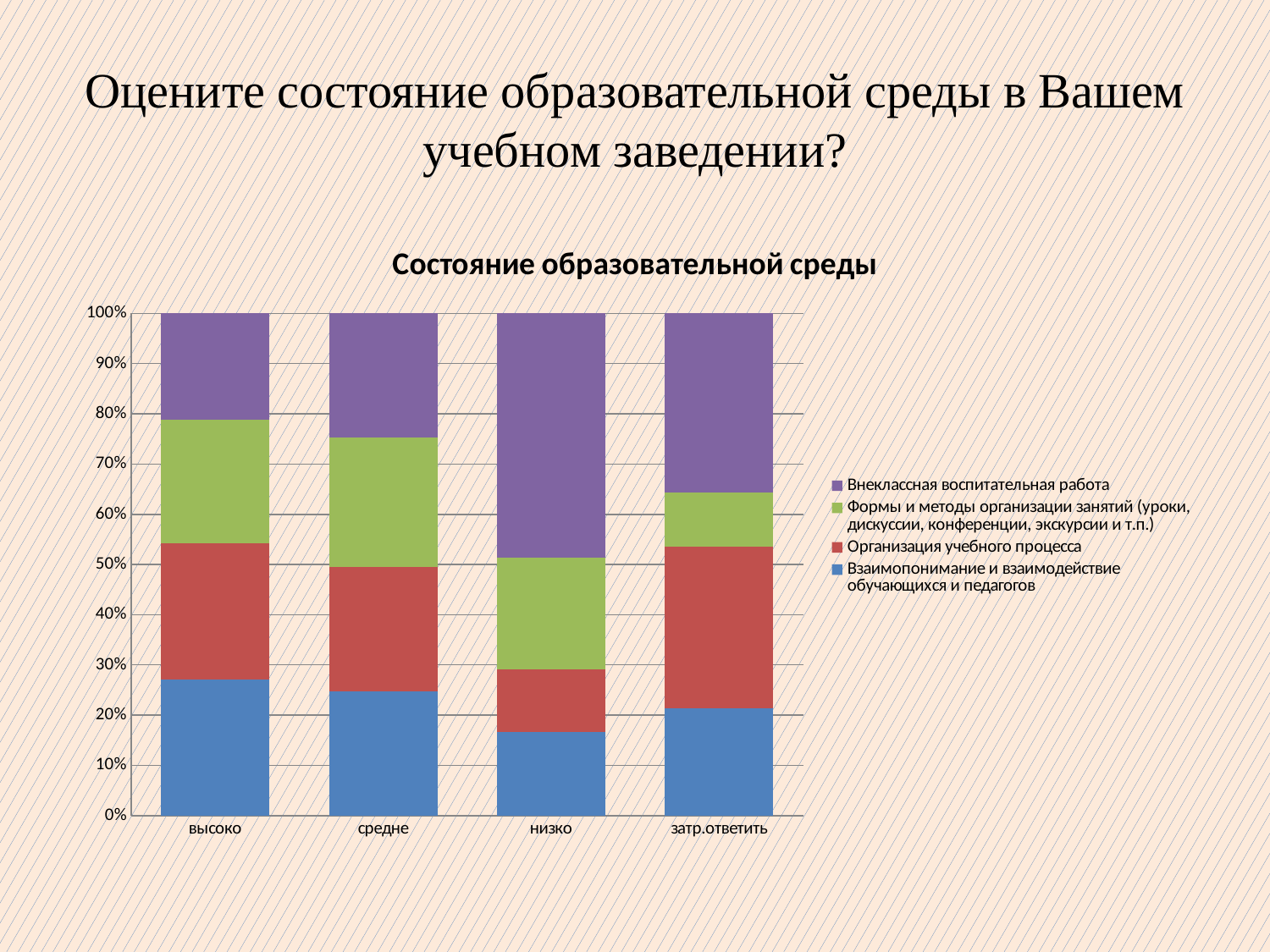
Is the share of "Внеклассная воспитательная работа" in the "низко" bar greater or less than 40%? greater How many series does the legend list? 4 Which series is shown in purple at the top of each bar? Внеклассная воспитательная работа Is the share of "Взаимопонимание и взаимодействие обучающихся и педагогов" in the "низко" bar greater or less than 20%? less How many categories are shown on the x axis of the chart? 4 Is the share of "Взаимопонимание и взаимодействие обучающихся и педагогов" in the "высоко" bar greater or less than 20%? greater What kind of chart is shown on the slide? stacked bar chart Which category has the smallest segment for "Формы и методы организации занятий"? затр.ответить Which category has the smallest segment for "Взаимопонимание и взаимодействие обучающихся и педагогов"? низко What is the title of the chart? Состояние образовательной среды Which category has the largest segment for "Внеклассная воспитательная работа"? низко